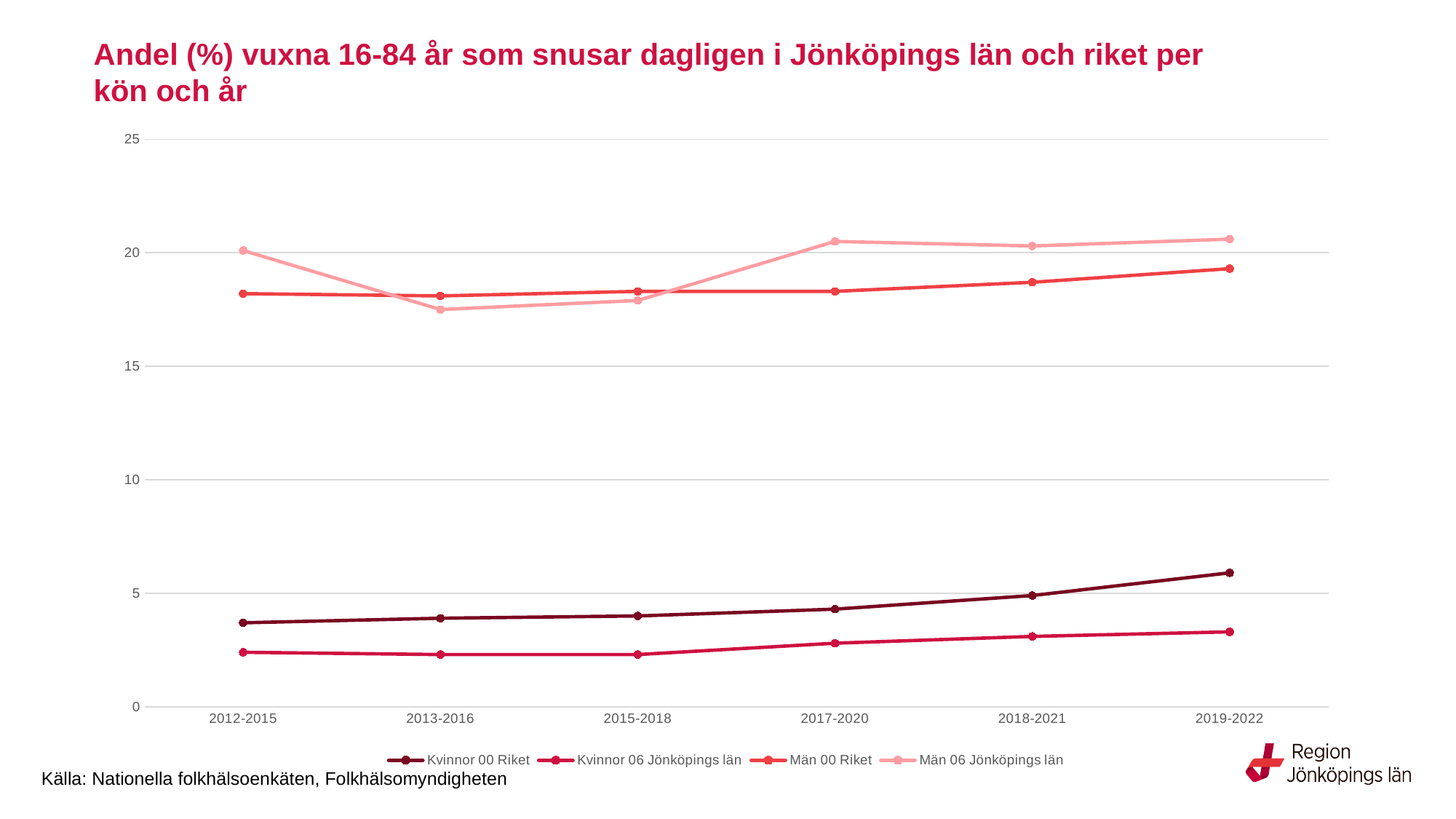
Which series has the lowest value in 2012-2015? Kvinnor 06 Jönköpings län Is the value for Män 06 Jönköpings län in 2013-2016 greater or less than 20? less Does the Kvinnor 00 Riket line rise or fall from 2012-2015 to 2019-2022? rise Is the value for Kvinnor 06 Jönköpings län in 2012-2015 greater or less than 5? less How many series does the legend list? 4 In 2019-2022, which is higher: Män 00 Riket or Kvinnor 00 Riket? Män 00 Riket How many time periods are shown on the x axis? 6 Is the value for Män 00 Riket in 2012-2015 greater or less than 15? greater Which series has the highest value in 2019-2022? Män 06 Jönköpings län In 2017-2020, which is higher: Män 06 Jönköpings län or Män 00 Riket? Män 06 Jönköpings län What kind of chart is shown on the slide? line chart